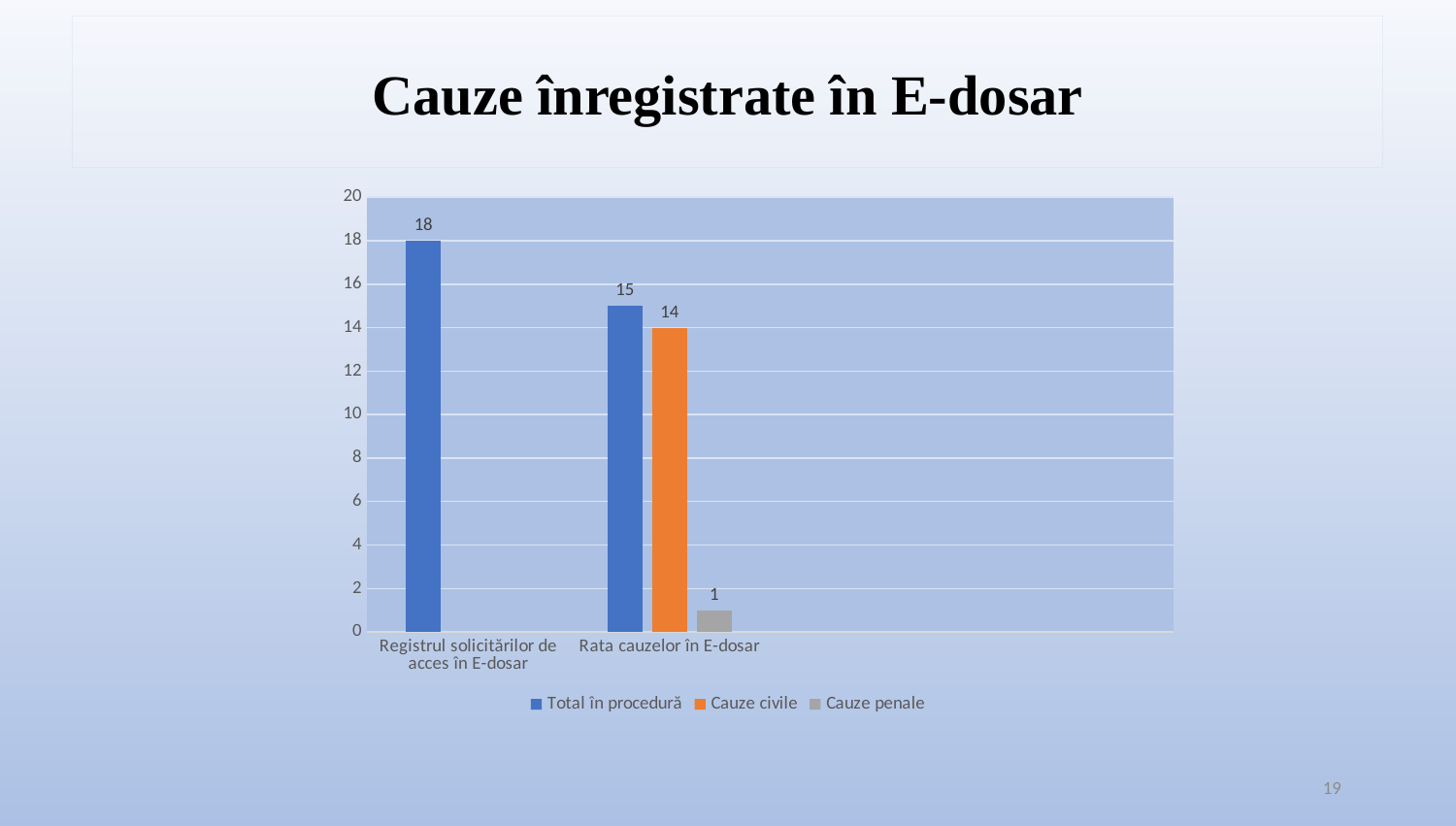
Which series has the lowest value for "Rata cauzelor în E-dosar"? Cauze penale What is the title of the slide? Cauze înregistrate în E-dosar What is the value of "Total în procedură" for "Registrul solicitărilor de acces în E-dosar"? 18 How many categories are shown on the x axis? 2 Which category has the higher "Total în procedură" value? Registrul solicitărilor de acces în E-dosar What is the difference between the "Total în procedură" values of the two categories? 3 What kind of chart is shown on the slide? Bar chart What is the value of "Total în procedură" for "Rata cauzelor în E-dosar"? 15 How many series does the legend list? 3 What is the value of "Cauze civile" for "Rata cauzelor în E-dosar"? 14 What is the value of "Cauze penale" for "Rata cauzelor în E-dosar"? 1 What is the difference between "Cauze civile" and "Cauze penale" for "Rata cauzelor în E-dosar"? 13